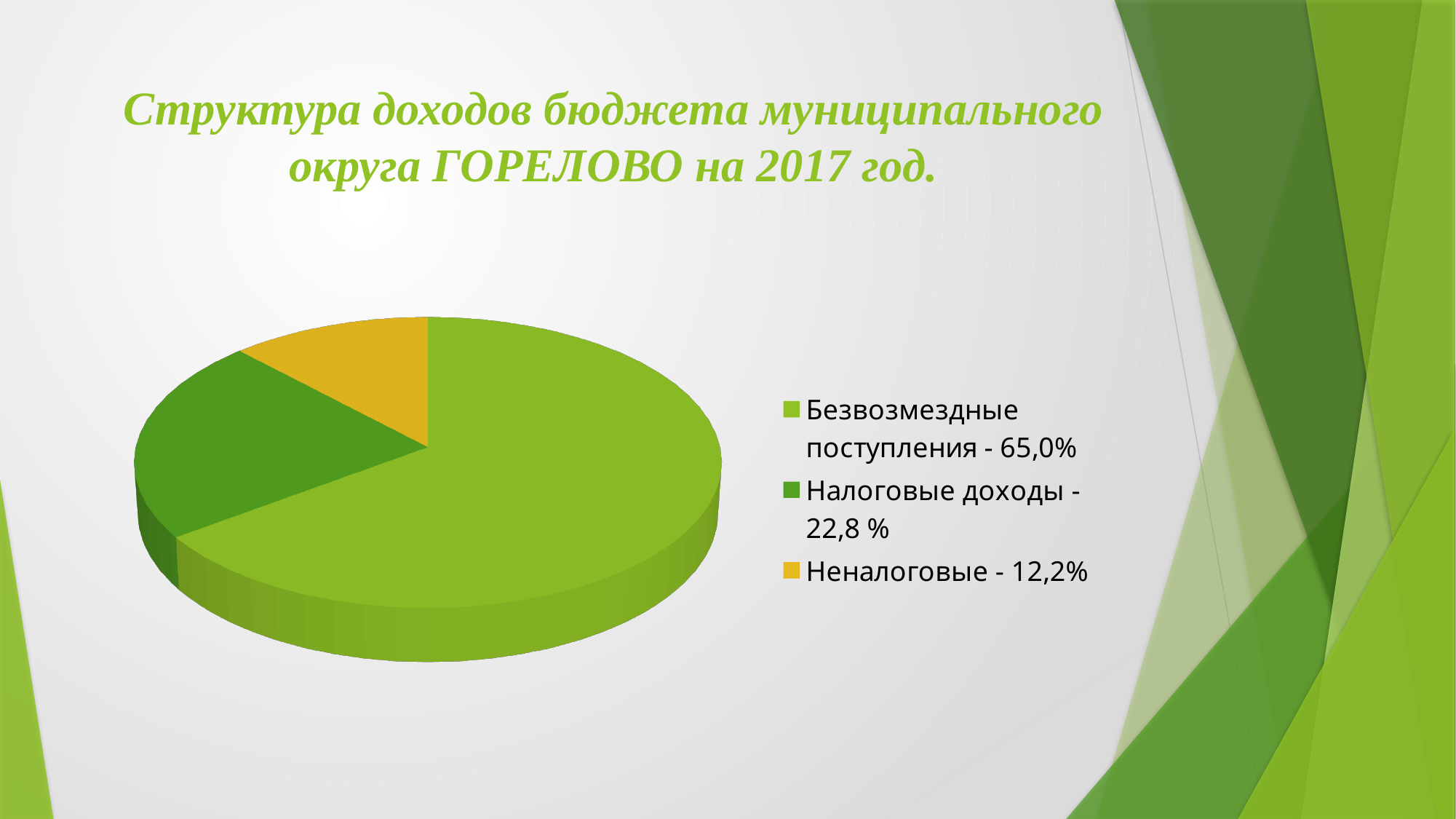
Which category has the smallest slice of the pie? Неналоговые How many slices does the pie chart have? 3 Which category has the largest slice of the pie? Безвозмездные поступления What share of the pie is Налоговые доходы? 22,8 % What share of the pie is Безвозмездные поступления? 65,0% What kind of chart is shown on the slide? Pie chart What is the difference in percentage points between Безвозмездные поступления and Налоговые доходы? 42,2 Which is larger, Налоговые доходы or Неналоговые? Налоговые доходы What is the difference in percentage points between Налоговые доходы and Неналоговые? 10,6 What is the title of the chart on the slide? Структура доходов бюджета муниципального округа ГОРЕЛОВО на 2017 год. What share of the pie is Неналоговые? 12,2% What colour is the slice for Неналоговые? Yellow